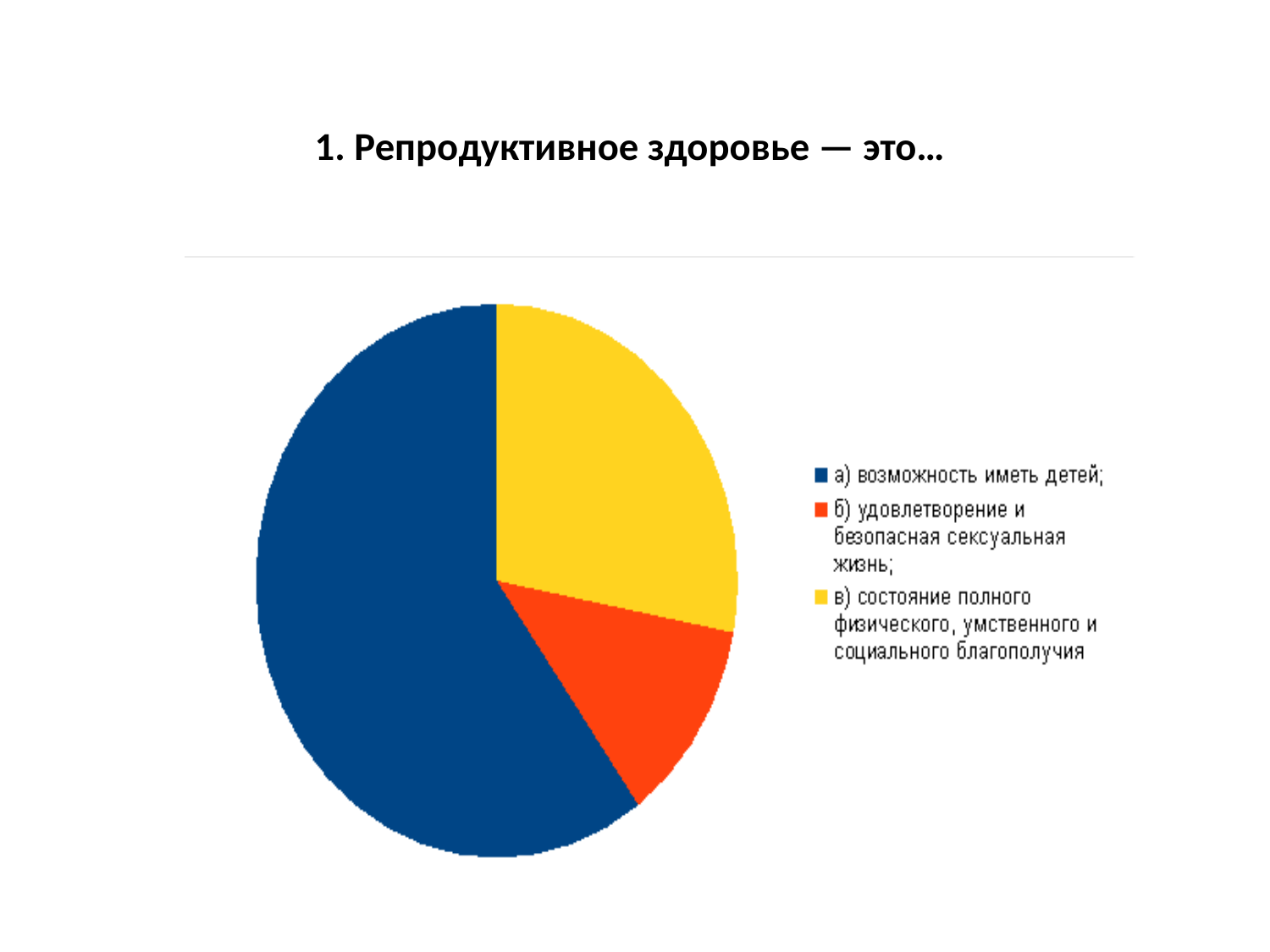
What kind of chart is shown on the slide? pie chart How many entries does the legend list? 3 Does the slice for "а) возможность иметь детей" take up more or less than half of the pie? more How many slices does the pie chart have? 3 What colour is the slice for "в) состояние полного физического, умственного и социального благополучия"? yellow What is the title of the slide above the chart? 1. Репродуктивное здоровье — это… Which answer option has the smallest slice of the pie? б) удовлетворение и безопасная сексуальная жизнь Which answer option has the largest slice of the pie? а) возможность иметь детей Which slice is larger: "а) возможность иметь детей" or "в) состояние полного физического, умственного и социального благополучия"? а) возможность иметь детей Which slice is larger: "б) удовлетворение и безопасная сексуальная жизнь" or "в) состояние полного физического, умственного и социального благополучия"? в) состояние полного физического, умственного и социального благополучия